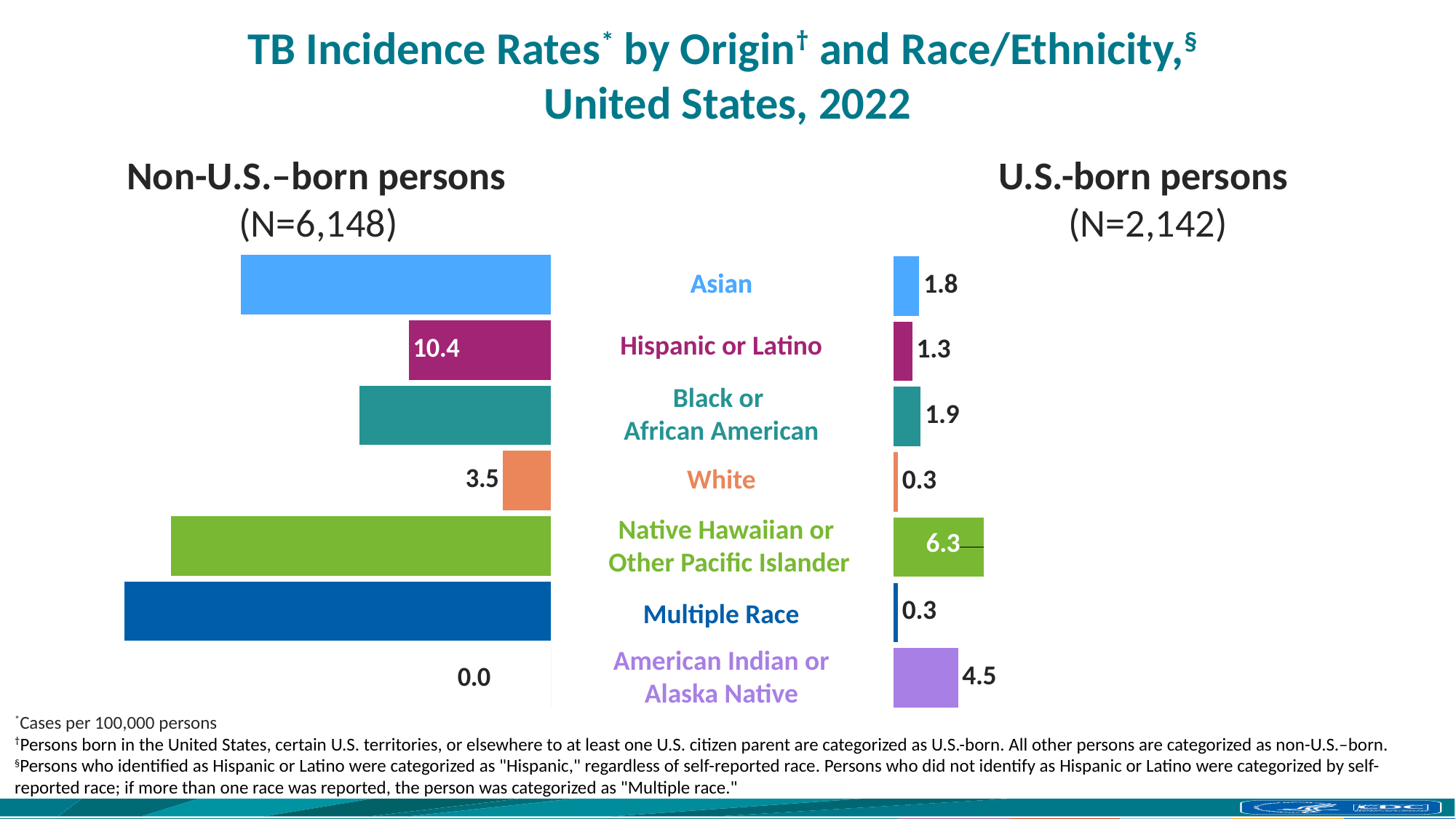
In the Non-U.S.-born persons chart, which race/ethnicity group has the lowest TB incidence rate? American Indian or Alaska Native In the Non-U.S.-born persons chart, what is the TB incidence rate for White persons? 3.5 In the U.S.-born persons chart, what is the TB incidence rate for American Indian or Alaska Native persons? 4.5 In the U.S.-born persons chart, which race/ethnicity group has the highest TB incidence rate? Native Hawaiian or Other Pacific Islander In the U.S.-born persons chart, what is the TB incidence rate for Native Hawaiian or Other Pacific Islander persons? 6.3 In the U.S.-born persons chart, what is the difference between the rates for Native Hawaiian or Other Pacific Islander and American Indian or Alaska Native persons? 1.8 In the Non-U.S.-born persons chart, which race/ethnicity group has the longest bar? Multiple Race How many race/ethnicity categories are shown in the U.S.-born persons chart? 7 What type of chart is used to show the TB incidence rates on this slide? Bar chart In the U.S.-born persons chart, what is the TB incidence rate for Black or African American persons? 1.9 In the Non-U.S.-born persons chart, what is the TB incidence rate for Hispanic or Latino persons? 10.4 In the Non-U.S.-born persons chart, which is larger: the rate for Hispanic or Latino persons or the rate for White persons? Hispanic or Latino